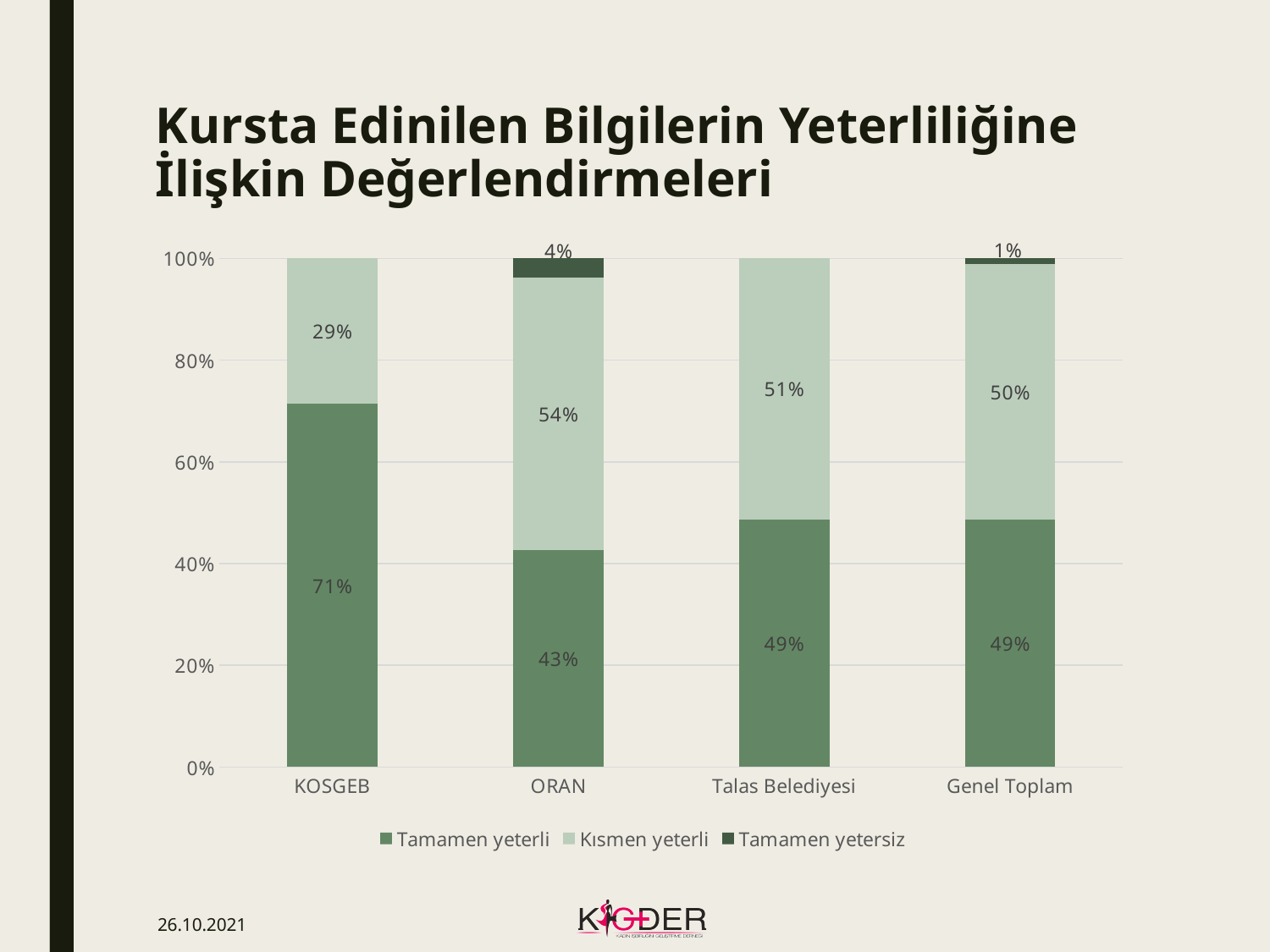
What is the difference between the "Tamamen yeterli" values for KOSGEB and ORAN? 28% What is the value of "Tamamen yetersiz" for ORAN? 4% Which is larger: the "Kısmen yeterli" value for KOSGEB or for Talas Belediyesi? Talas Belediyesi Which category has the highest "Tamamen yeterli" value? KOSGEB Which category has the lowest "Tamamen yeterli" value? ORAN What is the value of "Kısmen yeterli" for ORAN? 54% What is the value of "Tamamen yeterli" for KOSGEB? 71% How many series does the legend list? 3 What is the value of "Tamamen yetersiz" for Genel Toplam? 1% What is the value of "Kısmen yeterli" for Talas Belediyesi? 51% What kind of chart is shown on the slide? Stacked bar chart How many categories are shown on the x axis? 4